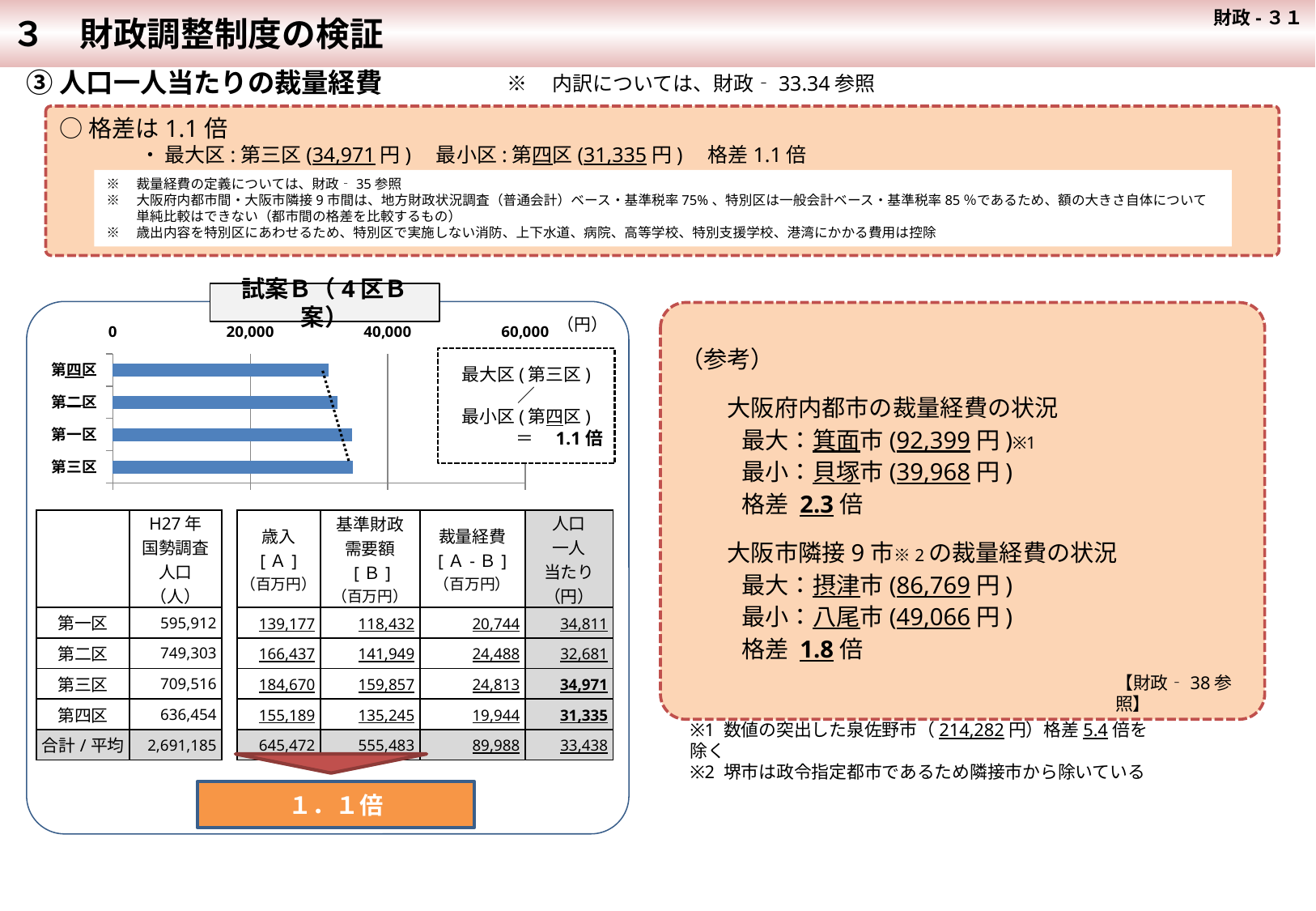
What is the title shown above the bar chart? 試案B（4区B案） What is the per-capita discretionary expense (人口一人当たり) for 第二区? 32,681 What kind of chart is shown on the slide? bar chart Which district has the lowest per-capita discretionary expense (人口一人当たり) in the chart? 第四区 What is the difference between the per-capita discretionary expense of 第三区 and 第四区? 3,636 How many districts (categories) are plotted in the bar chart? 4 Is the value for 第二区 in the bar chart greater or less than 20,000? greater Is the value for 第一区 in the bar chart greater or less than 40,000? less What unit is indicated at the end of the chart's horizontal axis? 円 What is the per-capita discretionary expense (人口一人当たり) for 第四区? 31,335 What is the per-capita discretionary expense (人口一人当たり) for 第三区? 34,971 Which district has the highest per-capita discretionary expense (人口一人当たり) in the chart? 第三区